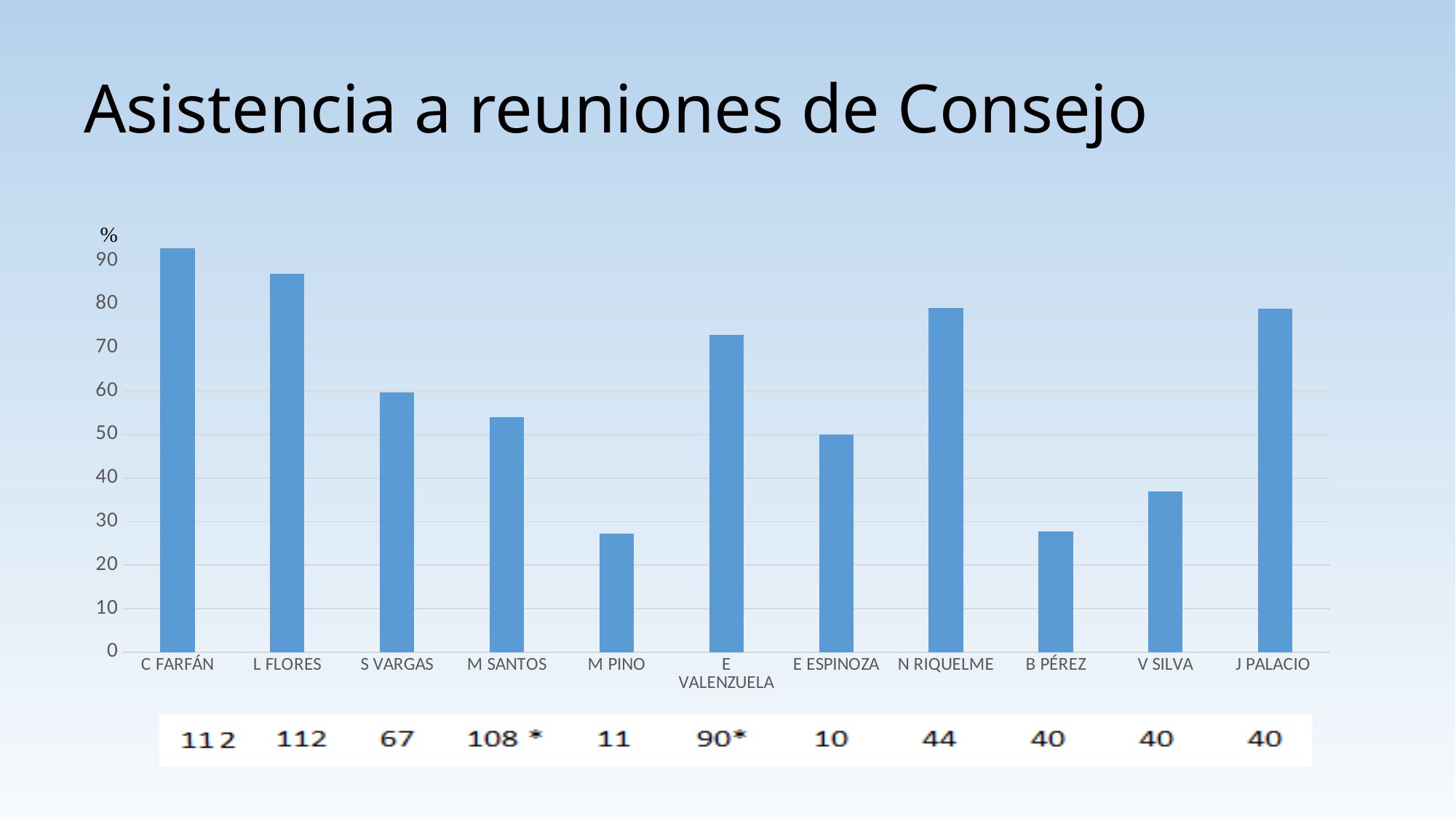
Which person has the highest attendance percentage in the chart? C FARFÁN What unit is indicated at the top of the vertical axis? % Which person has the lowest attendance percentage in the chart? M PINO What is the title of the slide? Asistencia a reuniones de Consejo Is the value for M SANTOS greater or less than 50? greater Is the value for V SILVA greater or less than 40? less How many people (categories) are shown on the x axis of the chart? 11 Which has a higher attendance percentage, E VALENZUELA or E ESPINOZA? E VALENZUELA What kind of chart is shown on the slide? bar chart Is the value for N RIQUELME greater or less than 70? greater Which has a higher attendance percentage, L FLORES or S VARGAS? L FLORES